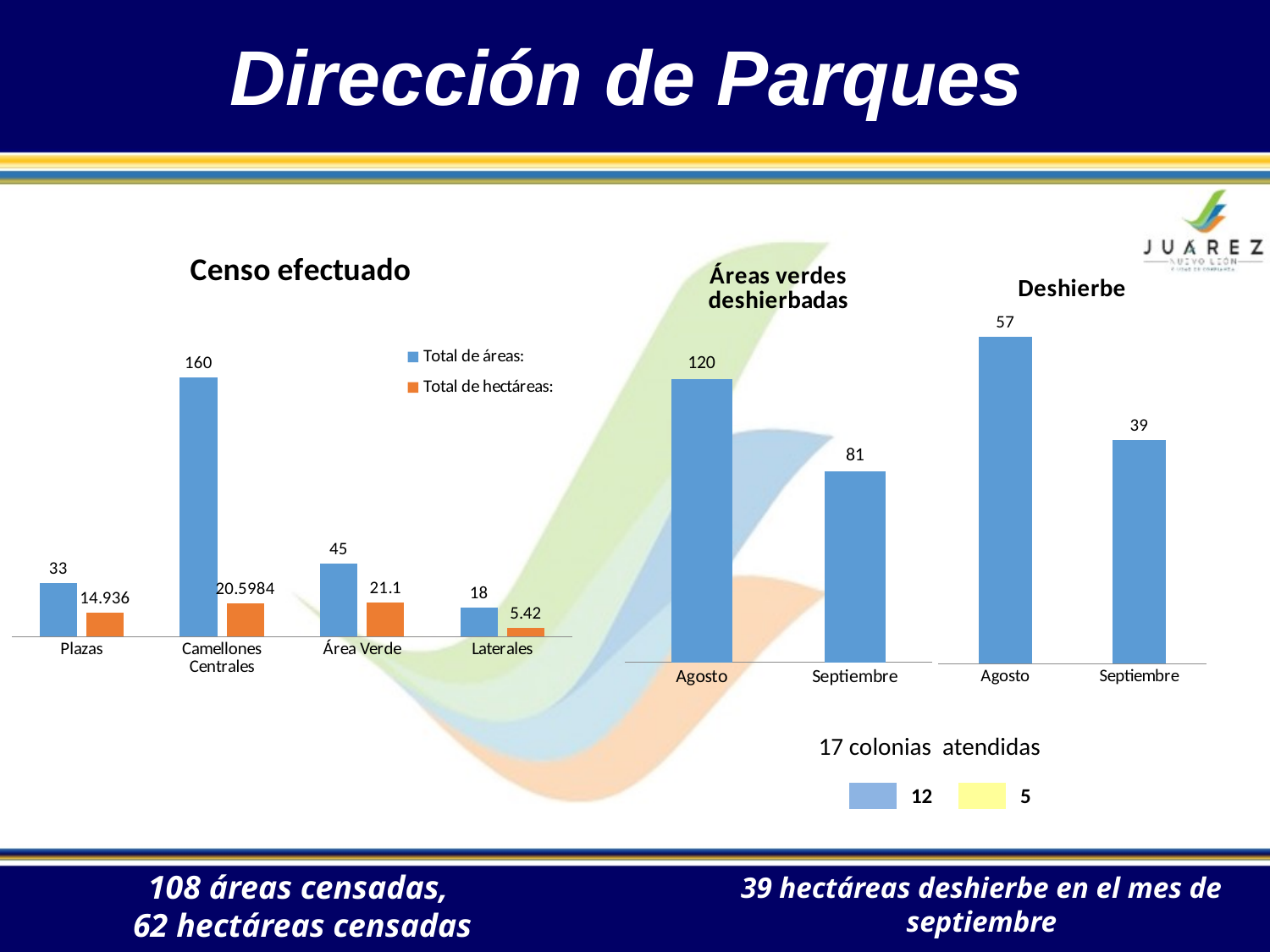
In the 'Censo efectuado' chart, what is the 'Total de áreas' value for Camellones Centrales? 160 In the 'Deshierbe' chart, what is the value for Agosto? 57 In the 'Áreas verdes deshierbadas' chart, what is the value for Septiembre? 81 In the 'Censo efectuado' chart, how many series does the legend list? 2 In the 'Censo efectuado' chart, which is larger: the 'Total de hectáreas' for Área Verde or for Camellones Centrales? Área Verde In the 'Censo efectuado' chart, how many categories are shown on the x axis? 4 What type of chart is the 'Deshierbe' chart? bar chart In the 'Censo efectuado' chart, what is the 'Total de hectáreas' value for Plazas? 14.936 In the 'Censo efectuado' chart, what is the difference between the 'Total de áreas' for Área Verde and for Laterales? 27 In the 'Deshierbe' chart, do the values rise or fall from Agosto to Septiembre? fall In the 'Censo efectuado' chart, which category has the lowest 'Total de áreas'? Laterales In the 'Áreas verdes deshierbadas' chart, what is the difference between Agosto and Septiembre? 39